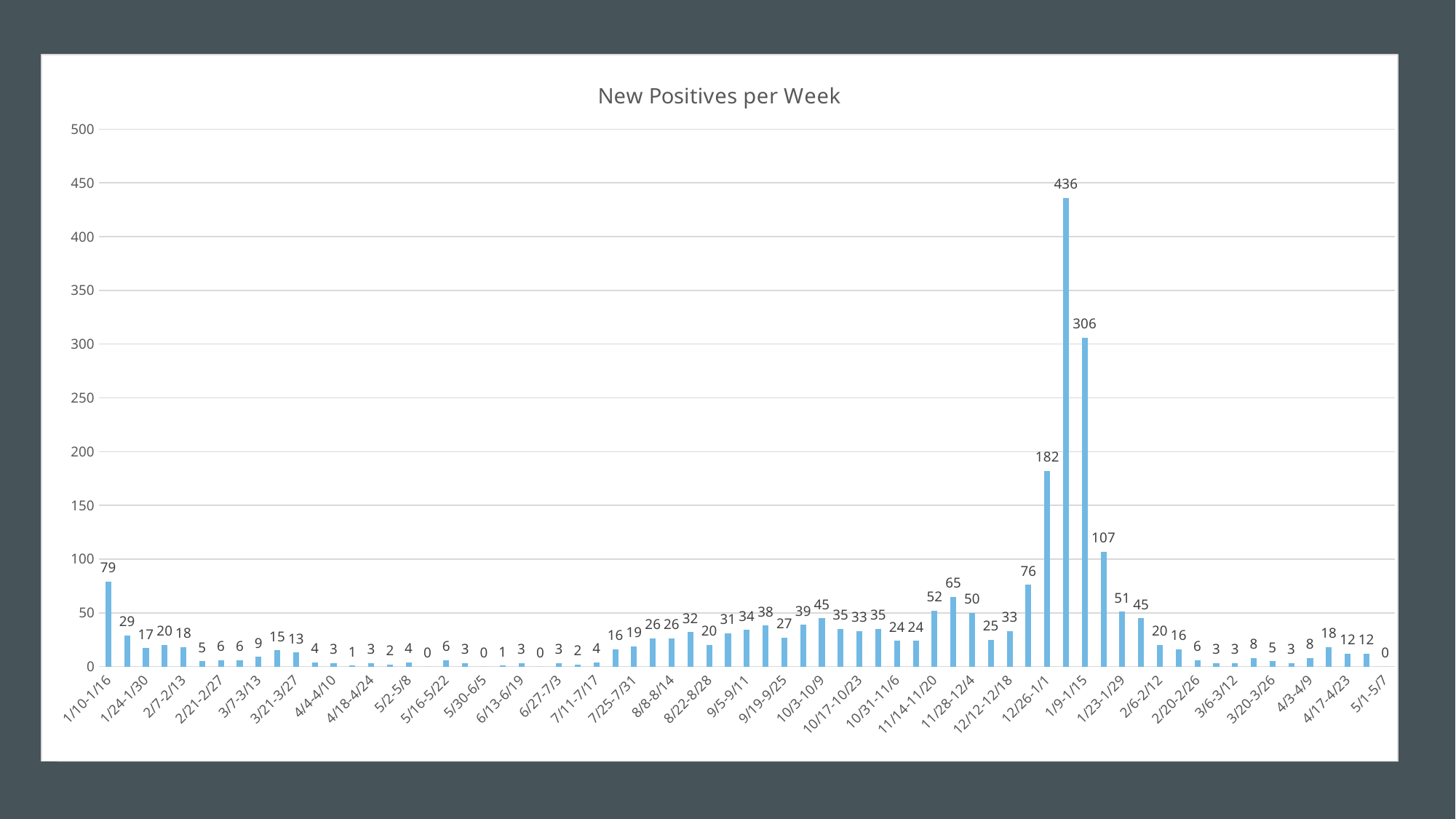
What is the difference between the highest bar (436) and the bar for 1/9-1/15 (306)? 130 What is the value for the week 11/14-11/20? 52 What is the title of the chart? New Positives per Week What kind of chart is shown on the slide? bar chart What is the difference between the values for 1/10-1/16 and 1/24-1/30? 62 What is the value for the week 12/26-1/1? 182 What is the value for the week 5/1-5/7? 0 What is the value for the week 1/10-1/16? 79 Which week has the larger value, 10/3-10/9 or 1/23-1/29? 1/23-1/29 What is the value for the week 1/9-1/15? 306 Is the value for the week 12/26-1/1 greater or less than 150? greater What is the highest value shown in the chart? 436